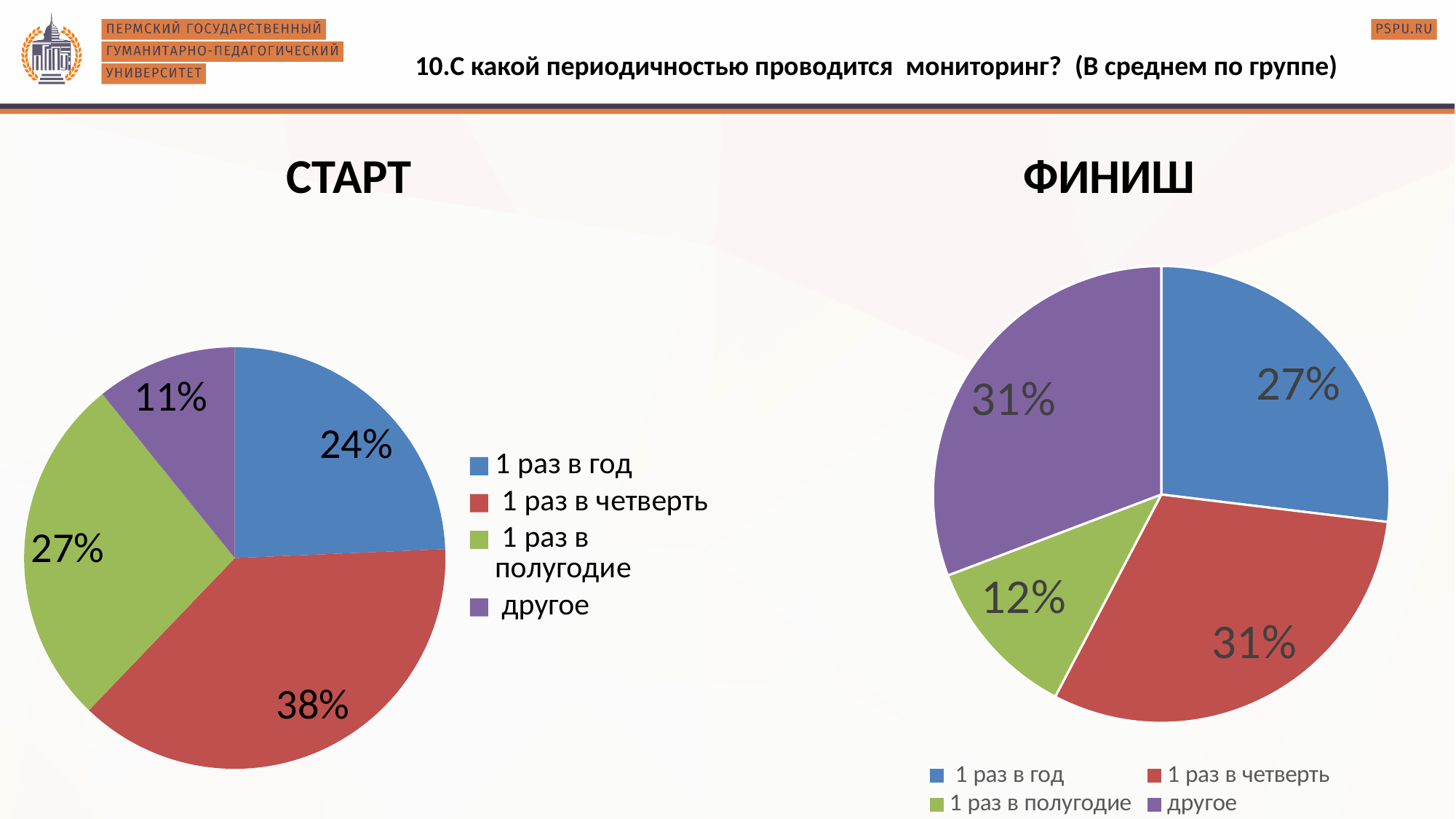
In the ФИНИШ pie chart, which category has the smallest share? 1 раз в полугодие How many slices does the ФИНИШ pie chart have? 4 In the ФИНИШ pie chart, what share is labelled for '1 раз в год'? 27% In the СТАРТ pie chart, what share is labelled for 'другое'? 11% In the СТАРТ pie chart, which category has the smallest share? другое In the ФИНИШ pie chart, what share is labelled for '1 раз в полугодие'? 12% In the СТАРТ pie chart, which category has the largest share? 1 раз в четверть In the СТАРТ pie chart, what is the difference between the shares for '1 раз в четверть' and '1 раз в год'? 14% Which is larger in the СТАРТ pie chart: the share for '1 раз в полугодие' or the share for '1 раз в год'? 1 раз в полугодие In the ФИНИШ pie chart, what is the difference between the shares for 'другое' and '1 раз в полугодие'? 19% In the СТАРТ pie chart, what share is labelled for '1 раз в четверть'? 38% What type of chart is used for СТАРТ? Pie chart